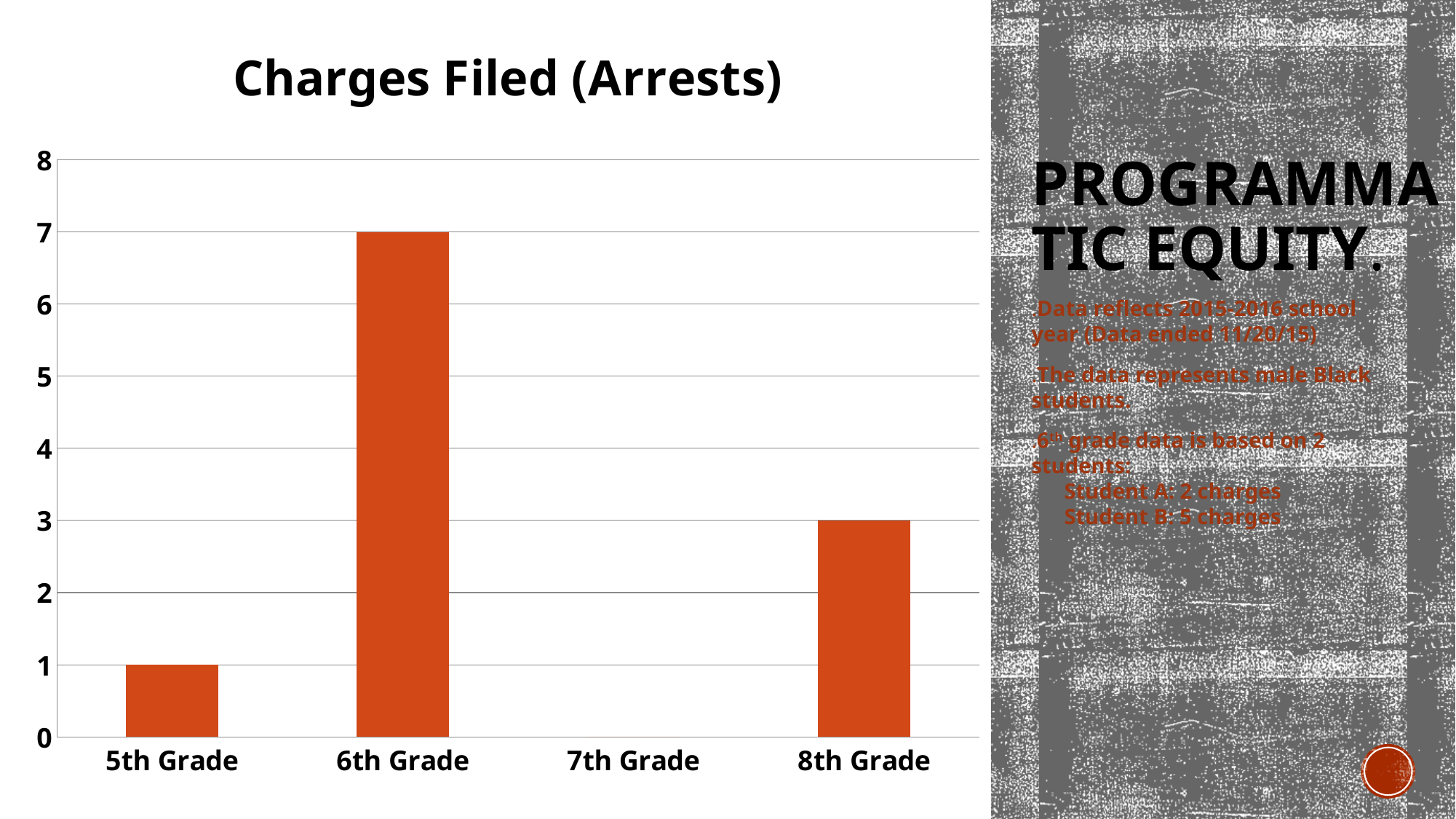
Which grade has the lowest number of charges filed? 7th Grade What is the value for 8th Grade in the Charges Filed (Arrests) chart? 3 What is the value for 6th Grade in the Charges Filed (Arrests) chart? 7 What is the value for 5th Grade in the Charges Filed (Arrests) chart? 1 What is the value for 7th Grade in the Charges Filed (Arrests) chart? 0 What kind of chart is shown on the slide? Bar chart What is the title of the chart? Charges Filed (Arrests) Is the value for 6th Grade greater or less than 5? greater Which is larger, the value for 8th Grade or the value for 5th Grade? 8th Grade How many grade categories are shown on the x axis? 4 Which grade has the highest number of charges filed? 6th Grade What is the difference between the values for 6th Grade and 8th Grade? 4